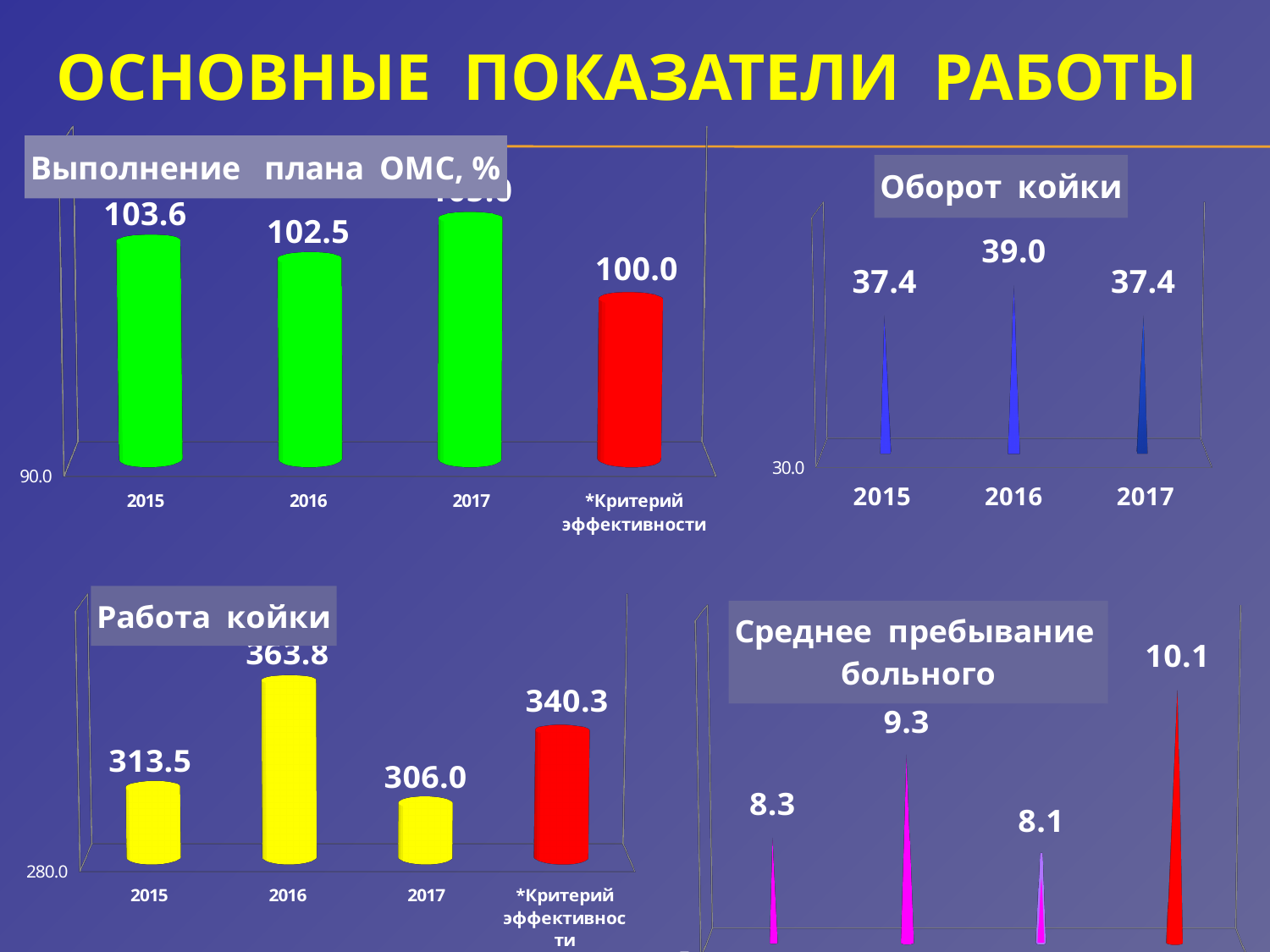
In the 'Выполнение плана ОМС, %' chart, what is the value for 2015? 103.6 In the 'Работа койки' chart, which year has the lowest value? 2017 In the 'Оборот койки' chart, how many categories are shown on the x axis? 3 In the 'Выполнение плана ОМС, %' chart, what is the difference between the 2015 and 2016 values? 1.1 In the 'Работа койки' chart, which is larger: the value for 2015 or the value for '*Критерий эффективности'? *Критерий эффективности In the 'Работа койки' chart, what is the difference between the 2016 value and the '*Критерий эффективности' value? 23.5 In the 'Оборот койки' chart, what is the value for 2017? 37.4 In the 'Оборот койки' chart, which year has the highest value? 2016 In the 'Выполнение плана ОМС, %' chart, what is the value for '*Критерий эффективности'? 100.0 What kind of chart is the 'Работа койки' chart? bar chart In the 'Работа койки' chart, what is the value for 2016? 363.8 In the 'Среднее пребывание больного' chart, what is the highest data label shown? 10.1